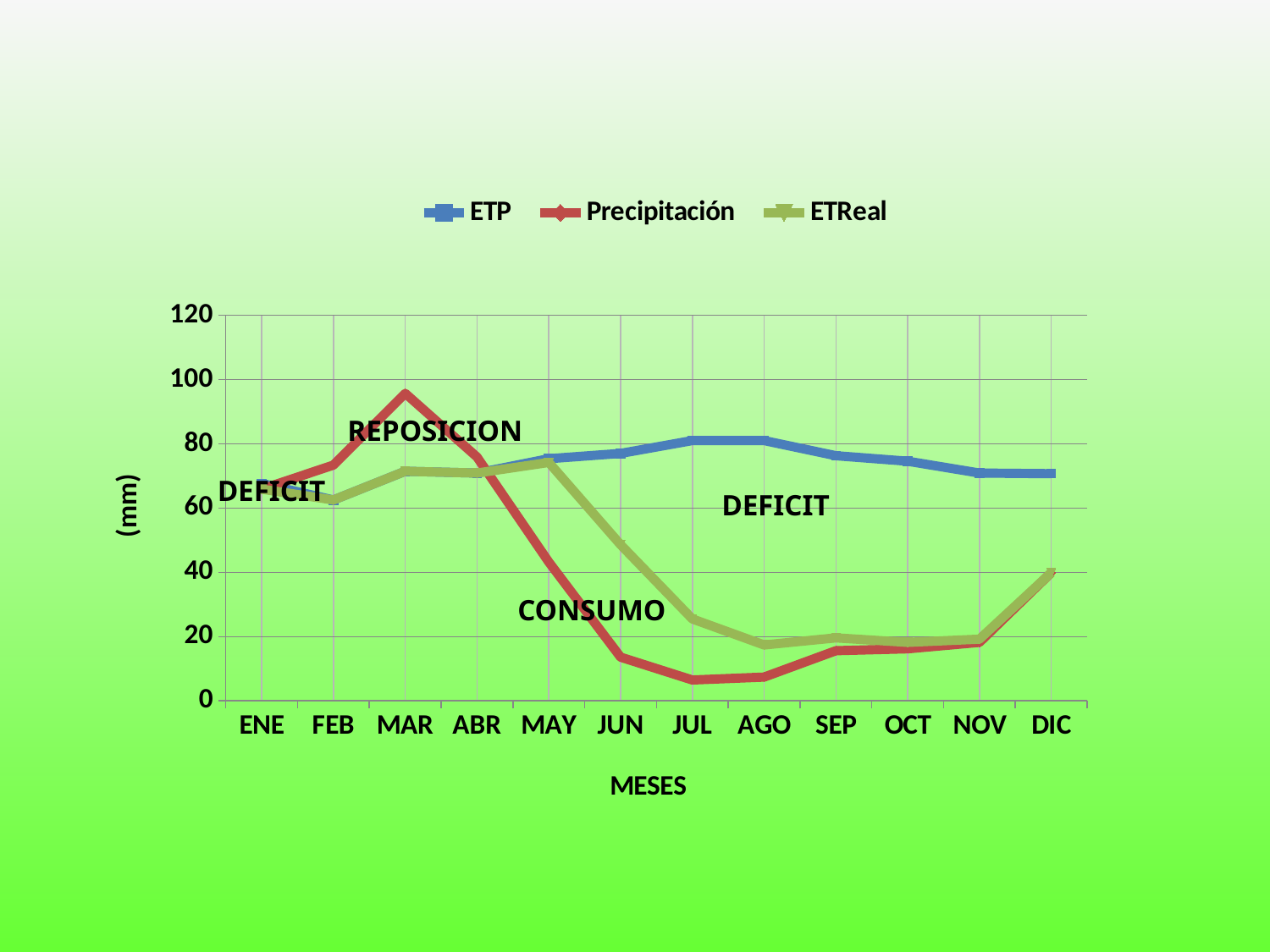
In JUL, which is larger: ETP or Precipitación? ETP What kind of chart is shown on the slide? line chart Is the value of ETReal in JUN greater or less than 40? greater How many months are plotted along the x axis? 12 Does Precipitación rise or fall from MAR to JUL? fall What is the title of the x axis? MESES In which month is Precipitación highest? MAR Is the value of Precipitación in JUL greater or less than 20? less How many series does the legend list? 3 In MAR, which is larger: Precipitación or ETP? Precipitación Is the value of Precipitación in MAR greater or less than 80? greater